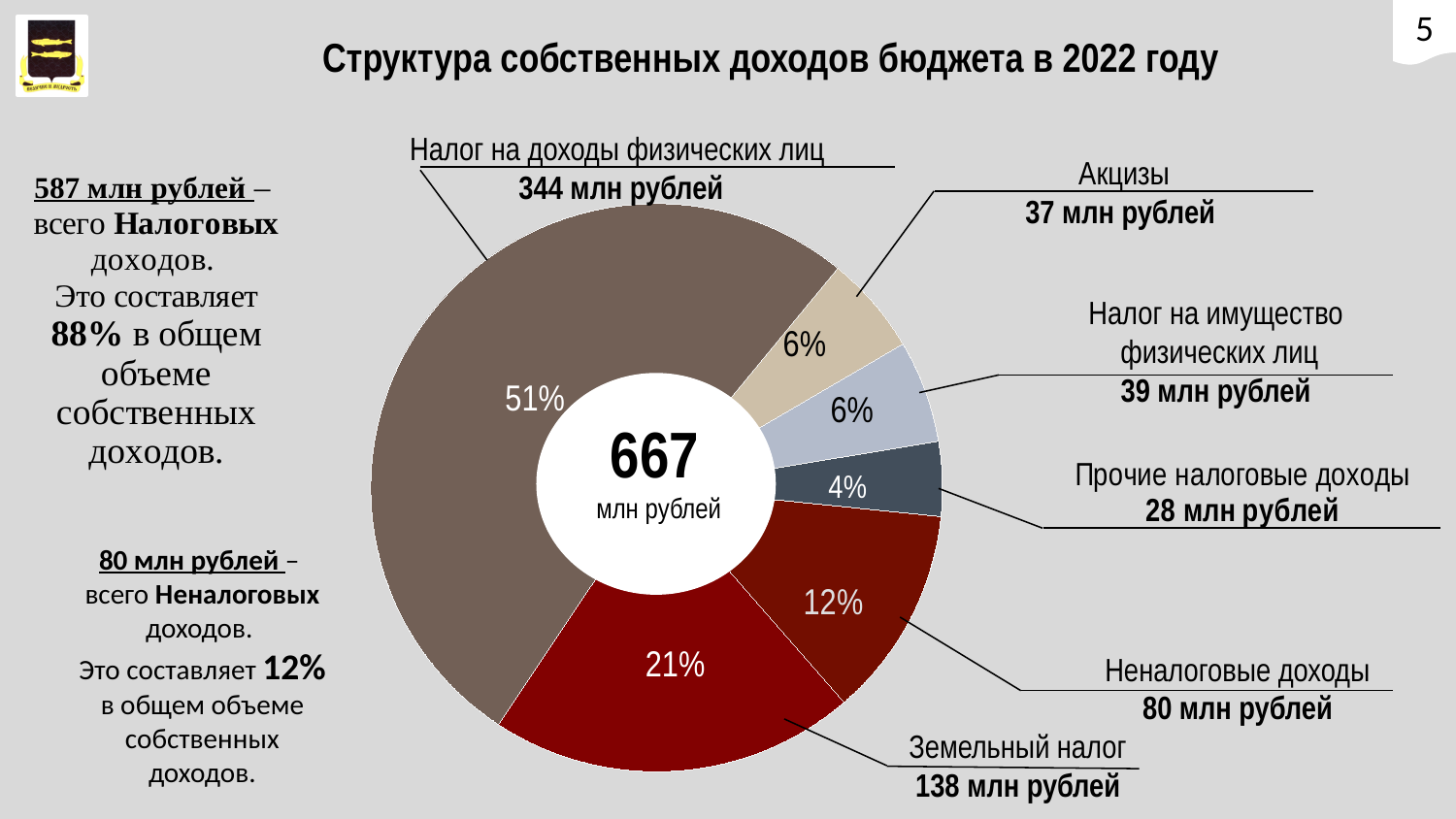
Which category has the smallest slice of the chart? Прочие налоговые доходы How many categories are shown in the chart? 6 What share of the chart does Земельный налог represent? 21% Which category has the largest slice of the chart? Налог на доходы физических лиц Which is larger, Неналоговые доходы or Акцизы? Неналоговые доходы What is the value for Прочие налоговые доходы? 28 млн рублей What total value is shown in the centre of the chart? 667 млн рублей What is the value for Налог на доходы физических лиц? 344 млн рублей What kind of chart is shown on the slide? Pie (donut) chart What is the difference between Налог на доходы физических лиц and Земельный налог? 206 млн рублей What share of the chart does Неналоговые доходы represent? 12% What is the value for Земельный налог? 138 млн рублей